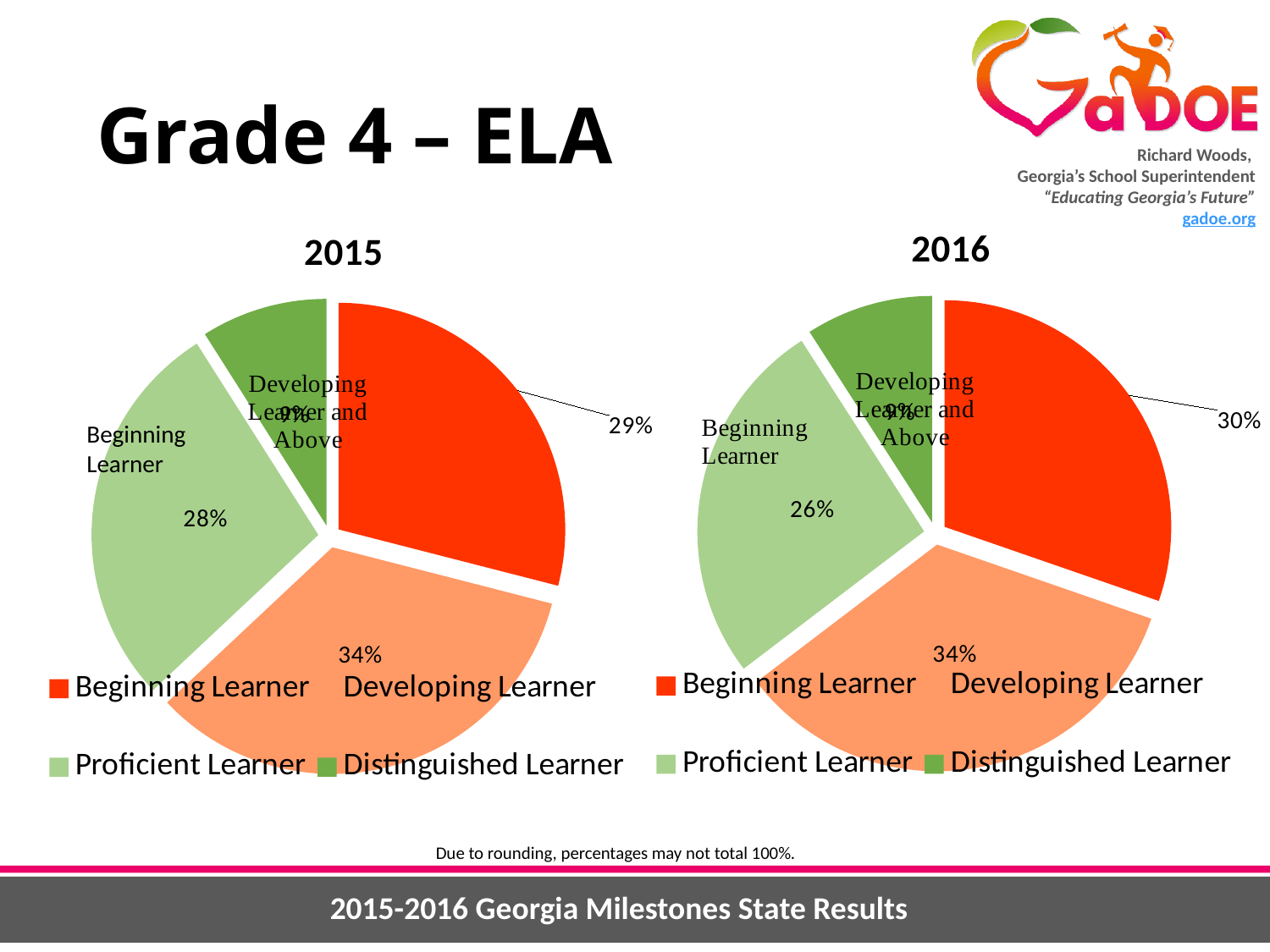
How many categories does the legend of the 2016 chart list? 4 In the 2016 pie chart, which category has the smallest share? Distinguished Learner In the 2016 pie chart, what percentage is shown for Proficient Learner? 26% In the 2016 pie chart, what percentage is shown for Beginning Learner? 30% In the 2015 pie chart, which category has the largest share? Developing Learner In the 2015 pie chart, what percentage is shown for Proficient Learner? 28% In the 2015 pie chart, how many percentage points larger is Developing Learner than Beginning Learner? 5 percentage points In the 2016 pie chart, what percentage is shown for Developing Learner? 34% In the 2015 pie chart, what percentage is shown for Beginning Learner? 29% Is the Beginning Learner share larger in the 2015 chart or the 2016 chart? 2016 In the 2015 pie chart, what percentage is shown for Developing Learner? 34% What type of chart is used to show the 2015 and 2016 results? Pie chart